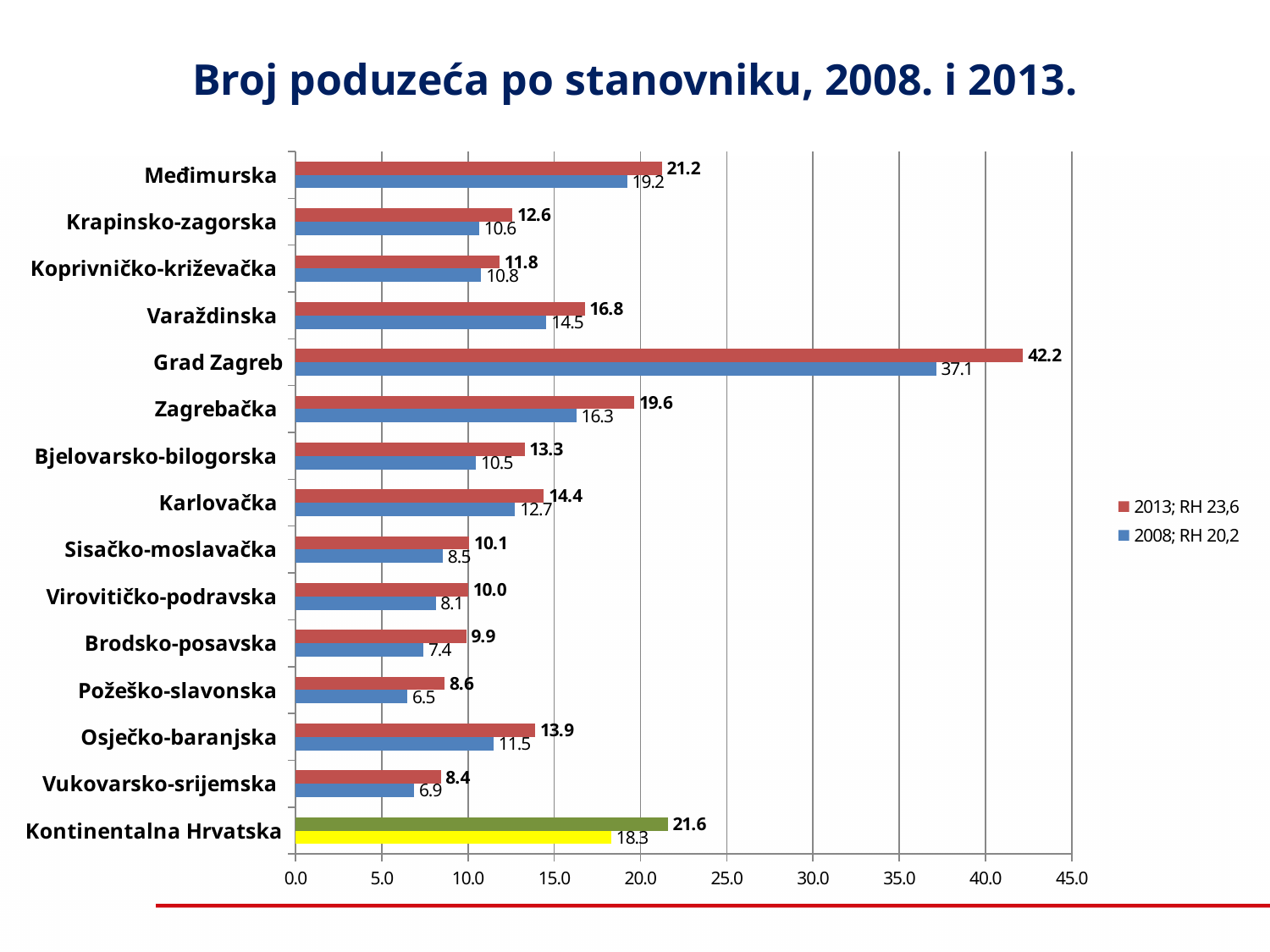
What is the 2013 value for Grad Zagreb? 42.2 What is the 2008 value for Međimurska? 19.2 What kind of chart is shown on the slide? Bar chart What is the 2008 value for Požeško-slavonska? 6.5 What is the difference between the 2013 and 2008 values for Grad Zagreb? 5.1 Which category has the lowest 2008 value? Požeško-slavonska What is the title of the chart? Broj poduzeća po stanovniku, 2008. i 2013. Which category has the highest 2013 value? Grad Zagreb Which is larger, the 2013 value for Varaždinska or the 2013 value for Karlovačka? Varaždinska How many categories are shown on the chart? 15 What is the 2013 value for Kontinentalna Hrvatska? 21.6 How many series does the legend list? 2